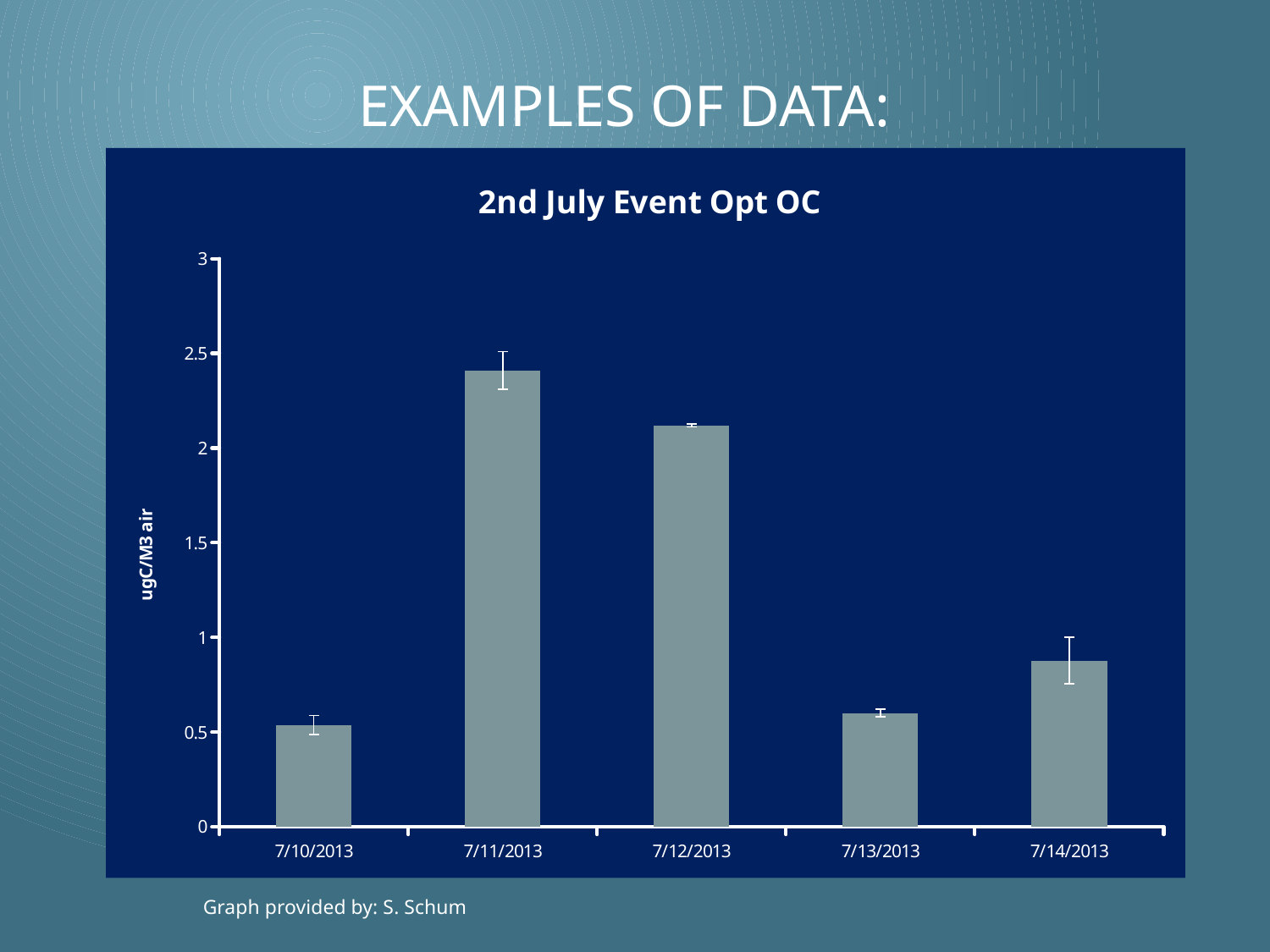
What kind of chart is shown on the slide? bar chart Which is larger, the value for 7/11/2013 or the value for 7/12/2013? 7/11/2013 Is the value for 7/12/2013 greater or less than 2? greater Is the value for 7/13/2013 greater or less than 1? less What is the label on the vertical axis of the chart? ugC/M3 air What is the title of the chart? 2nd July Event Opt OC Which is larger, the value for 7/13/2013 or the value for 7/14/2013? 7/14/2013 How many dates are plotted on the x axis of the chart? 5 Which date has the highest value in the chart? 7/11/2013 Is the value for 7/11/2013 greater or less than 2? greater